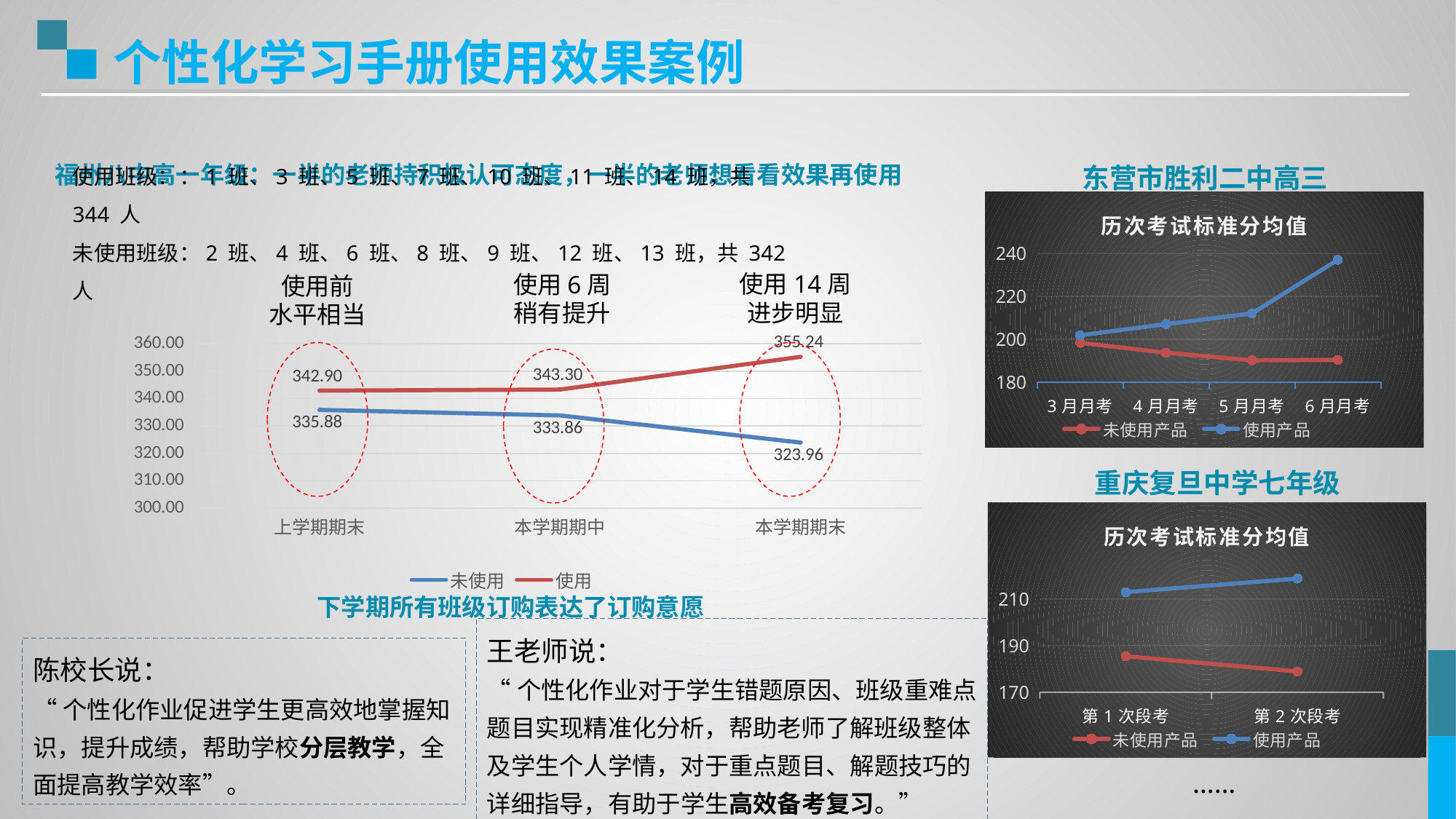
In the large line chart on the left, how many points are plotted along the x axis for each series? 3 What kind of chart is the 东营市胜利二中高三 chart? line chart In the 重庆复旦中学七年级 chart, is the value of 未使用产品 at 第2次段考 greater or less than 190? less In the large line chart on the left, at 本学期期中, which series has the larger value, 使用 or 未使用? 使用 In the large line chart on the left, what is the difference between the 使用 and 未使用 values at 本学期期末? 31.28 In the large line chart on the left, does the 未使用 series rise or fall from 上学期期末 to 本学期期末? fall In the large line chart on the left, what is the value of the 未使用 series at 上学期期末? 335.88 In the 东营市胜利二中高三 chart, how many exam categories are shown on the x axis? 4 In the large line chart on the left, what is the value of the 使用 series at 本学期期末? 355.24 In the large line chart on the left, how many series does the legend list? 2 In the 东营市胜利二中高三 chart, is the value of 使用产品 at 6月月考 greater or less than 220? greater In the 重庆复旦中学七年级 chart, does the 使用产品 series rise or fall from 第1次段考 to 第2次段考? rise